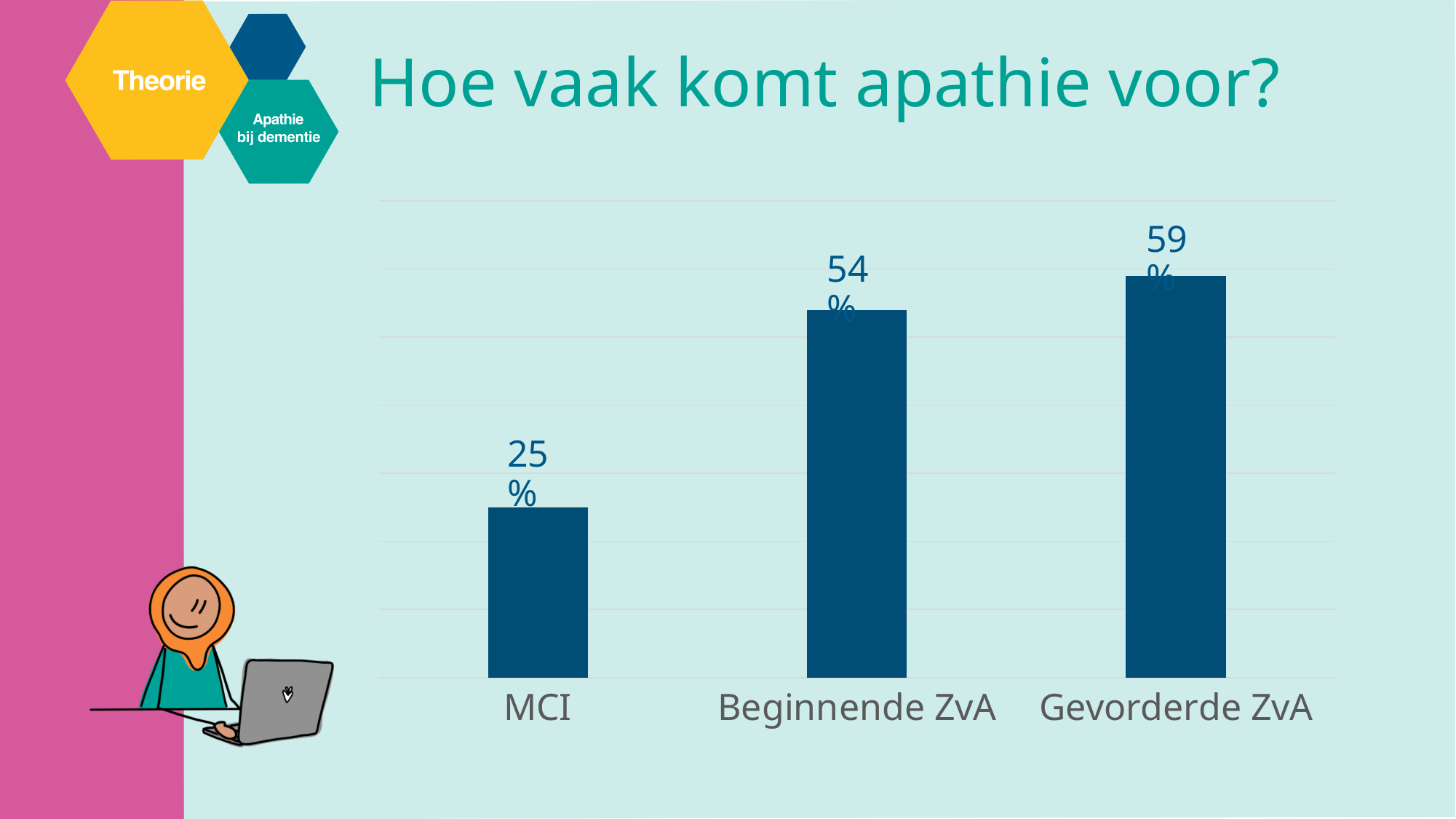
What is the difference between the values for Beginnende ZvA and MCI? 29% What is the value for MCI? 25% Do the values rise or fall from MCI to Gevorderde ZvA? Rise What is the value for Gevorderde ZvA? 59% What is the value for Beginnende ZvA? 54% What kind of chart is shown on the slide? Bar chart What is the title of the slide containing the chart? Hoe vaak komt apathie voor? Which category has the highest value? Gevorderde ZvA Which category has the lowest value? MCI Which is larger, the value for MCI or the value for Beginnende ZvA? Beginnende ZvA What is the difference between the values for Gevorderde ZvA and MCI? 34% How many categories are shown in the chart? 3